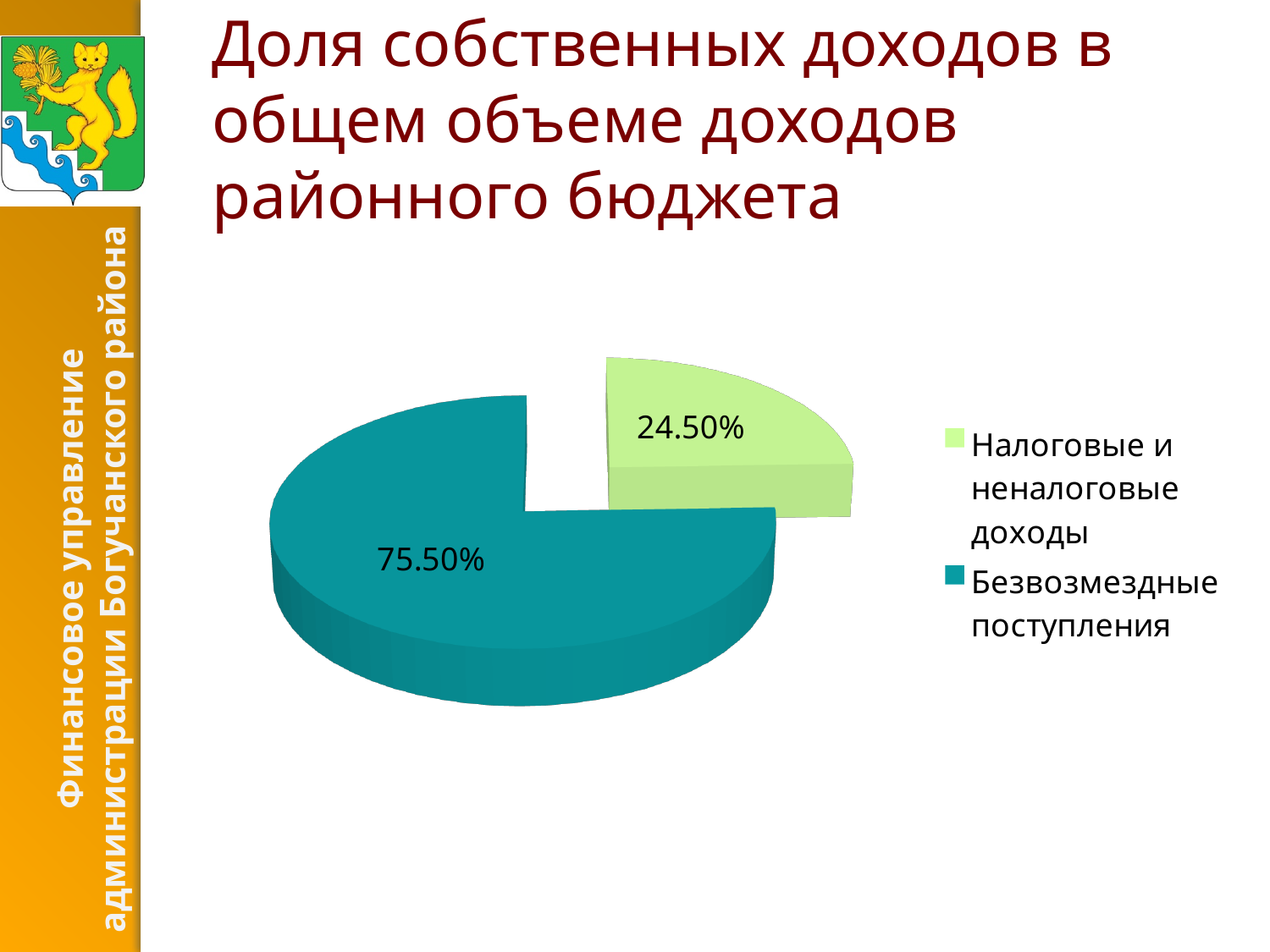
What colour is the slice for "Налоговые и неналоговые доходы"? Light green What share of the pie is labelled for "Налоговые и неналоговые доходы"? 24.50% What colour is the slice for "Безвозмездные поступления"? Teal What share of the pie is labelled for "Безвозмездные поступления"? 75.50% Is the share for "Налоговые и неналоговые доходы" greater or less than 50%? less How many entries does the legend list? 2 Which slice of the pie is the smallest? Налоговые и неналоговые доходы Which slice of the pie is the largest? Безвозмездные поступления What kind of chart is shown on the slide? Pie chart How many slices does the pie chart have? 2 What is the difference in percentage points between the "Безвозмездные поступления" slice and the "Налоговые и неналоговые доходы" slice? 51.00 percentage points Which is larger: the share for "Налоговые и неналоговые доходы" or the share for "Безвозмездные поступления"? Безвозмездные поступления